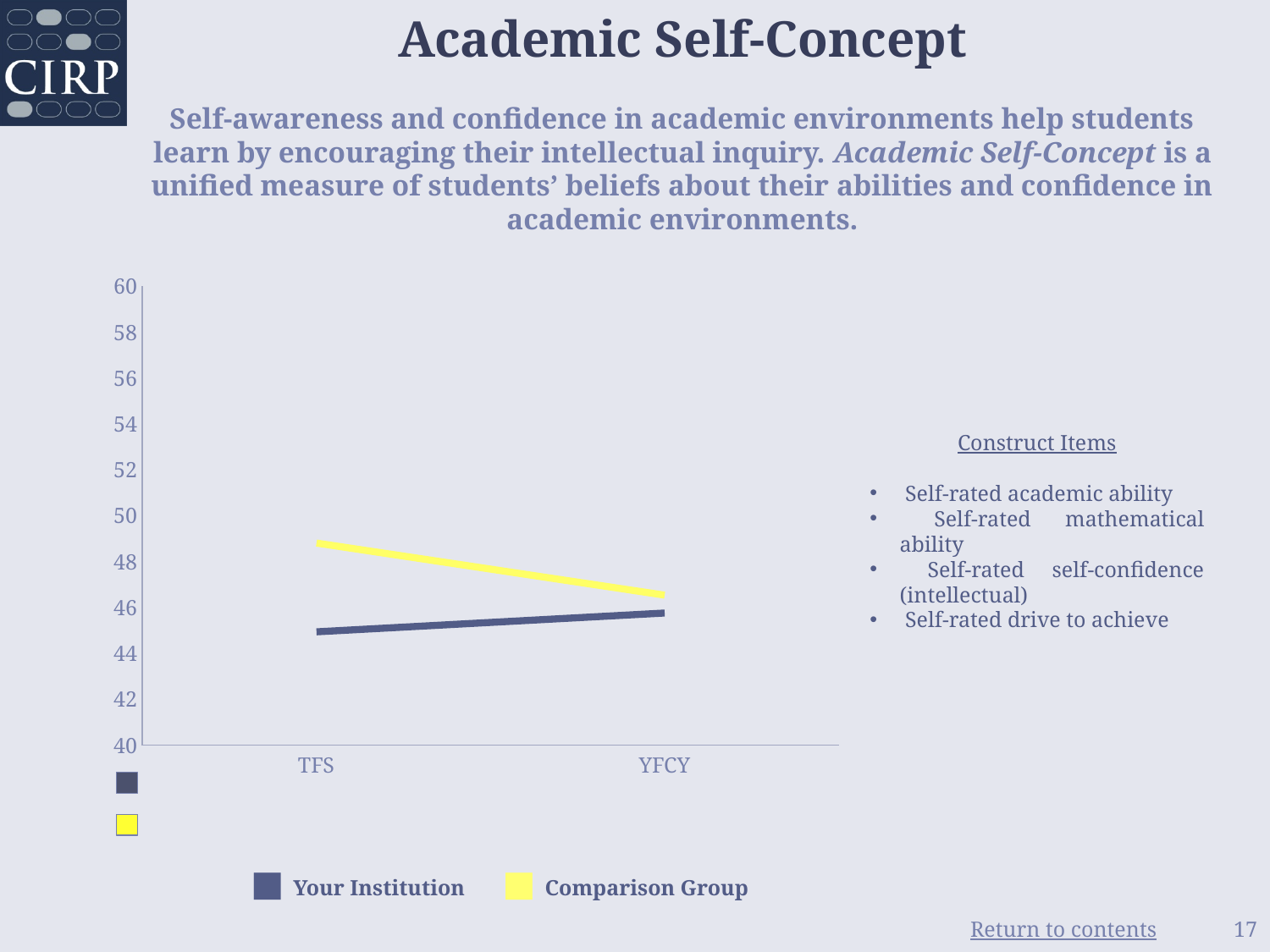
Is the Your Institution value at TFS greater or less than 44? greater Is the Comparison Group value at TFS greater or less than 48? greater How many points are there along the x axis? 2 What kind of chart is shown on the slide? line chart How many series does the legend list? 2 What are the two categories on the x axis? TFS and YFCY Is the Your Institution value at TFS greater or less than 46? less At TFS, which series has the higher value, Your Institution or Comparison Group? Comparison Group Does the Comparison Group line rise or fall from TFS to YFCY? fall Does the Your Institution line rise or fall from TFS to YFCY? rise Which series is shown in yellow? Comparison Group